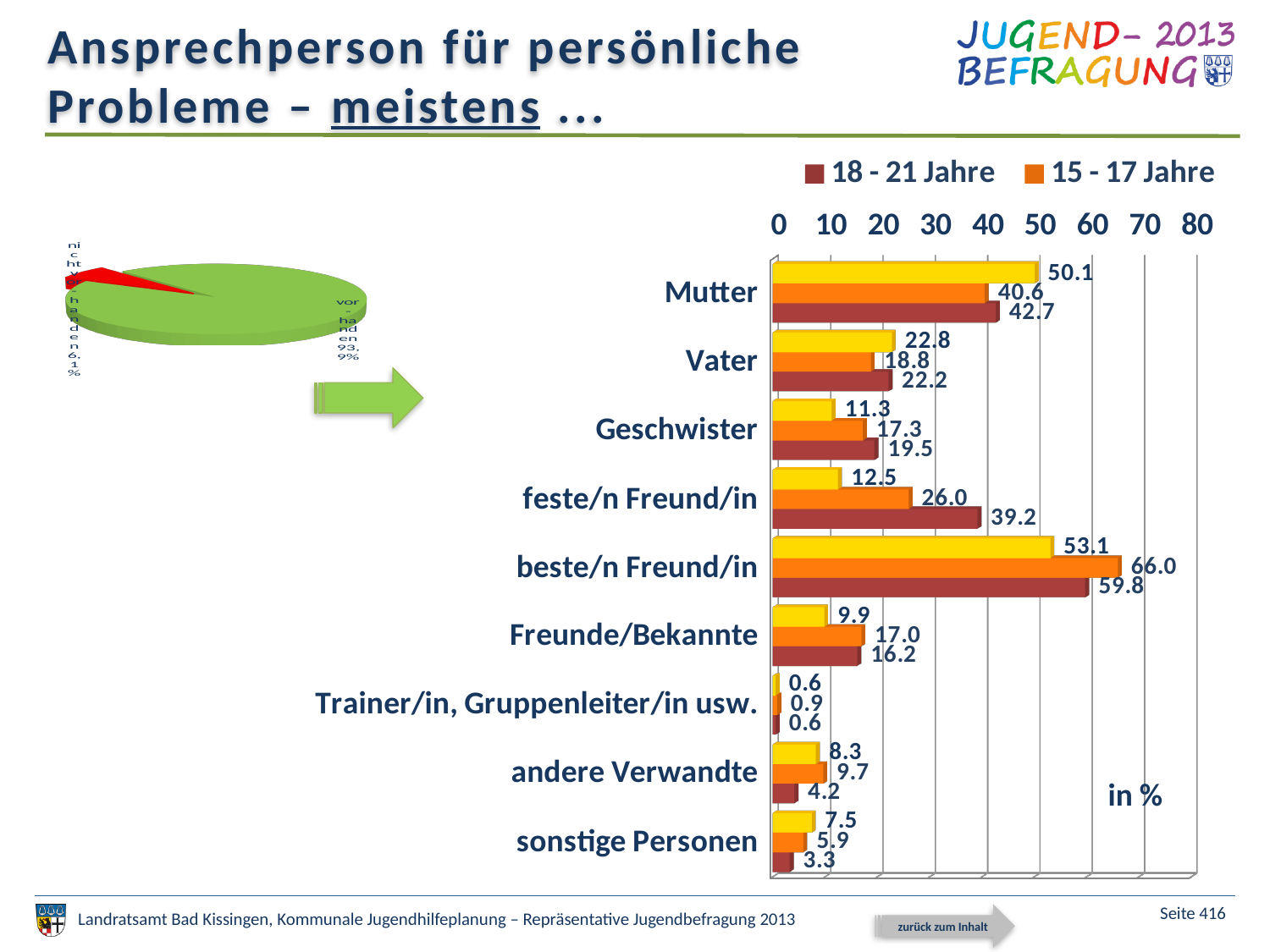
What kind of chart is the small chart on the left of the slide? pie chart How many series does the legend of the bar chart on the right list? 2 In the bar chart on the right, is the 15 - 17 Jahre value for beste/n Freund/in greater or less than 60? greater In the bar chart on the right, which category has the highest value in the 15 - 17 Jahre series? beste/n Freund/in In the bar chart on the right, what is the value for feste/n Freund/in in the 18 - 21 Jahre series? 39.2 What kind of chart is the chart on the right of the slide? bar chart How many categories are shown in the bar chart on the right? 9 In the bar chart on the right, what is the value for beste/n Freund/in in the 18 - 21 Jahre series? 59.8 In the bar chart on the right, which category has the lowest value in the 18 - 21 Jahre series? Trainer/in, Gruppenleiter/in usw. In the bar chart on the right, what is the difference between the 18 - 21 Jahre and 15 - 17 Jahre values for feste/n Freund/in? 13.2 In the bar chart on the right, which is larger for Geschwister: the 15 - 17 Jahre value or the 18 - 21 Jahre value? 18 - 21 Jahre In the bar chart on the right, what is the value for Mutter in the 15 - 17 Jahre series? 40.6